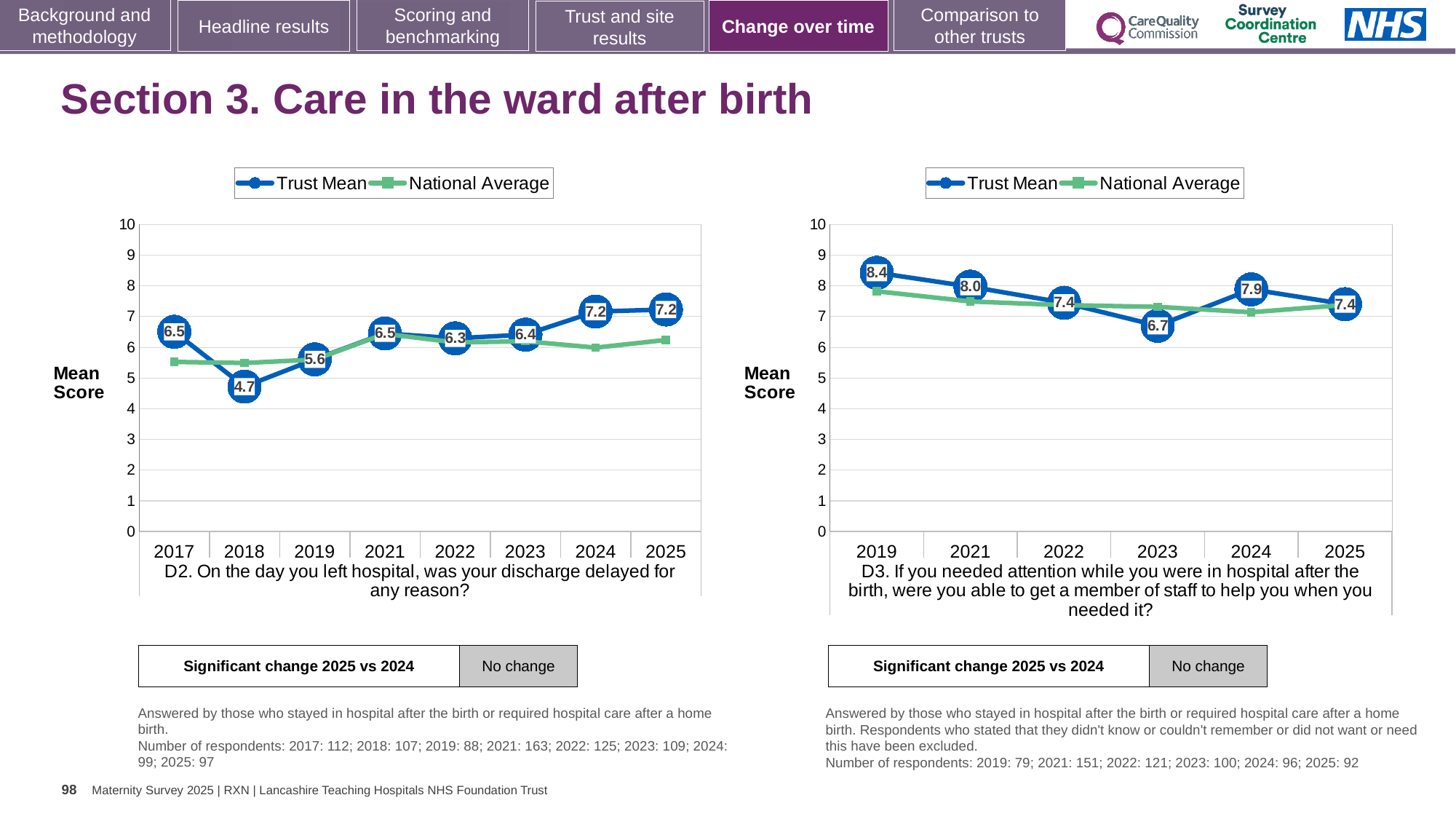
In the D2 chart (left), what is the Trust Mean score for 2025? 7.2 In the D2 chart (left), how many years are shown on the x axis? 8 In the D3 chart (right), what is the Trust Mean score for 2023? 6.7 In the D3 chart (right), which year has the highest Trust Mean score? 2019 In the D2 chart (left), which year has the lowest Trust Mean score? 2018 In the D3 chart (right), is the National Average value for 2019 greater or less than 7? greater In the D3 chart (right), how many series does the legend list? 2 In the D2 chart (left), is the National Average value for 2018 greater or less than 6? less In the D2 chart (left), what is the Trust Mean score for 2018? 4.7 In the D3 chart (right), which is larger, the Trust Mean score for 2021 or for 2024? 2021 In the D2 chart (left), what is the difference between the Trust Mean scores for 2024 and 2018? 2.5 What kind of chart is the D3 chart on the right? Line chart